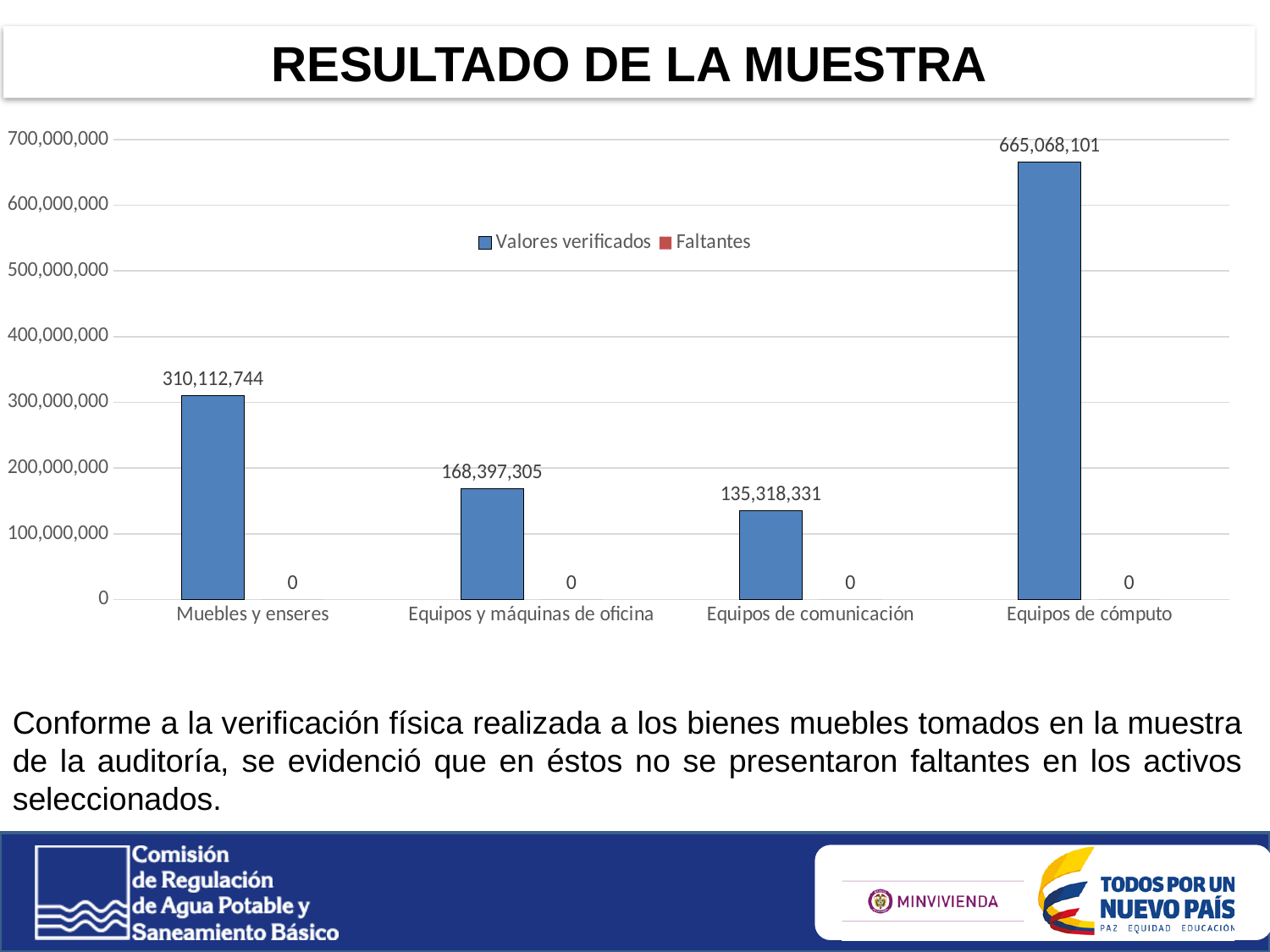
Which category has the lowest Valores verificados? Equipos de comunicación How many categories are shown on the x axis? 4 Which has a larger Valores verificados value, Equipos y máquinas de oficina or Equipos de comunicación? Equipos y máquinas de oficina Is the Valores verificados value for Muebles y enseres greater or less than 400,000,000? less What is the difference in Valores verificados between Equipos de cómputo and Muebles y enseres? 354,955,357 What is the value of Valores verificados for Equipos de cómputo? 665,068,101 What type of chart is shown on the slide? bar chart What is the Faltantes value for Equipos y máquinas de oficina? 0 Which category has the highest Valores verificados? Equipos de cómputo What is the value of Valores verificados for Muebles y enseres? 310,112,744 How many series does the legend list? 2 What is the value of Valores verificados for Equipos de comunicación? 135,318,331